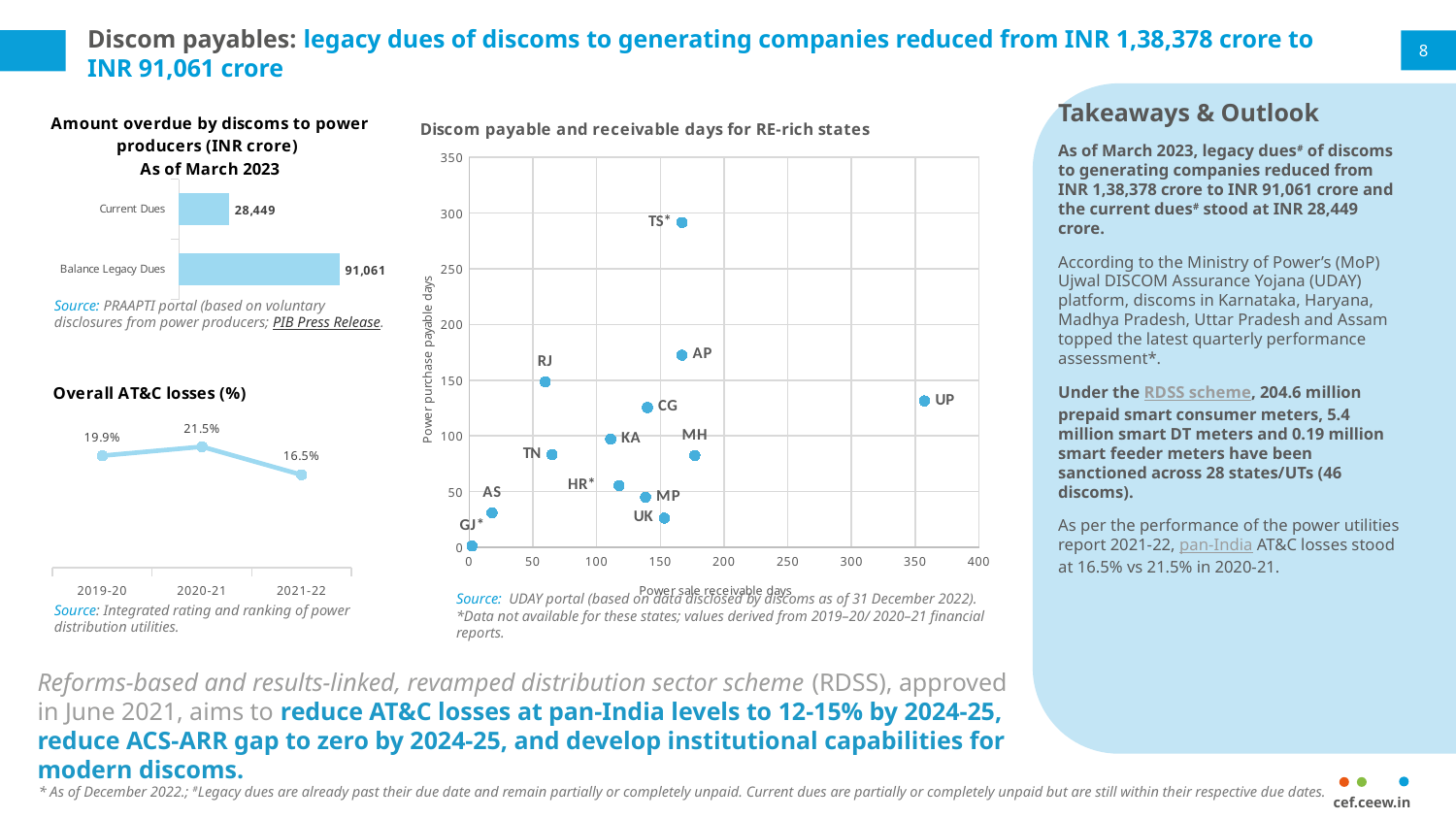
What kind of chart is the 'Amount overdue by discoms to power producers' chart? Bar chart In the 'Discom payable and receivable days for RE-rich states' chart, is the power sale receivable days value for UP greater or less than 300? greater In the 'Overall AT&C losses (%)' chart, what is the value for 2021-22? 16.5% In the 'Amount overdue by discoms to power producers' chart, what is the value for Balance Legacy Dues? 91,061 In the 'Overall AT&C losses (%)' chart, what is the value for 2020-21? 21.5% In the 'Overall AT&C losses (%)' chart, which year has the lowest value? 2021-22 In the 'Overall AT&C losses (%)' chart, what is the difference between the 2020-21 and 2021-22 values? 5 percentage points In the 'Amount overdue by discoms to power producers' chart, what is the difference between Balance Legacy Dues and Current Dues? 62,612 How many data points are plotted in the 'Overall AT&C losses (%)' chart? 3 In the 'Amount overdue by discoms to power producers' chart, what is the value for Current Dues? 28,449 In the 'Amount overdue by discoms to power producers' chart, which category has the larger value? Balance Legacy Dues In the 'Discom payable and receivable days for RE-rich states' chart, is the power purchase payable days value for TS* greater or less than 250? greater